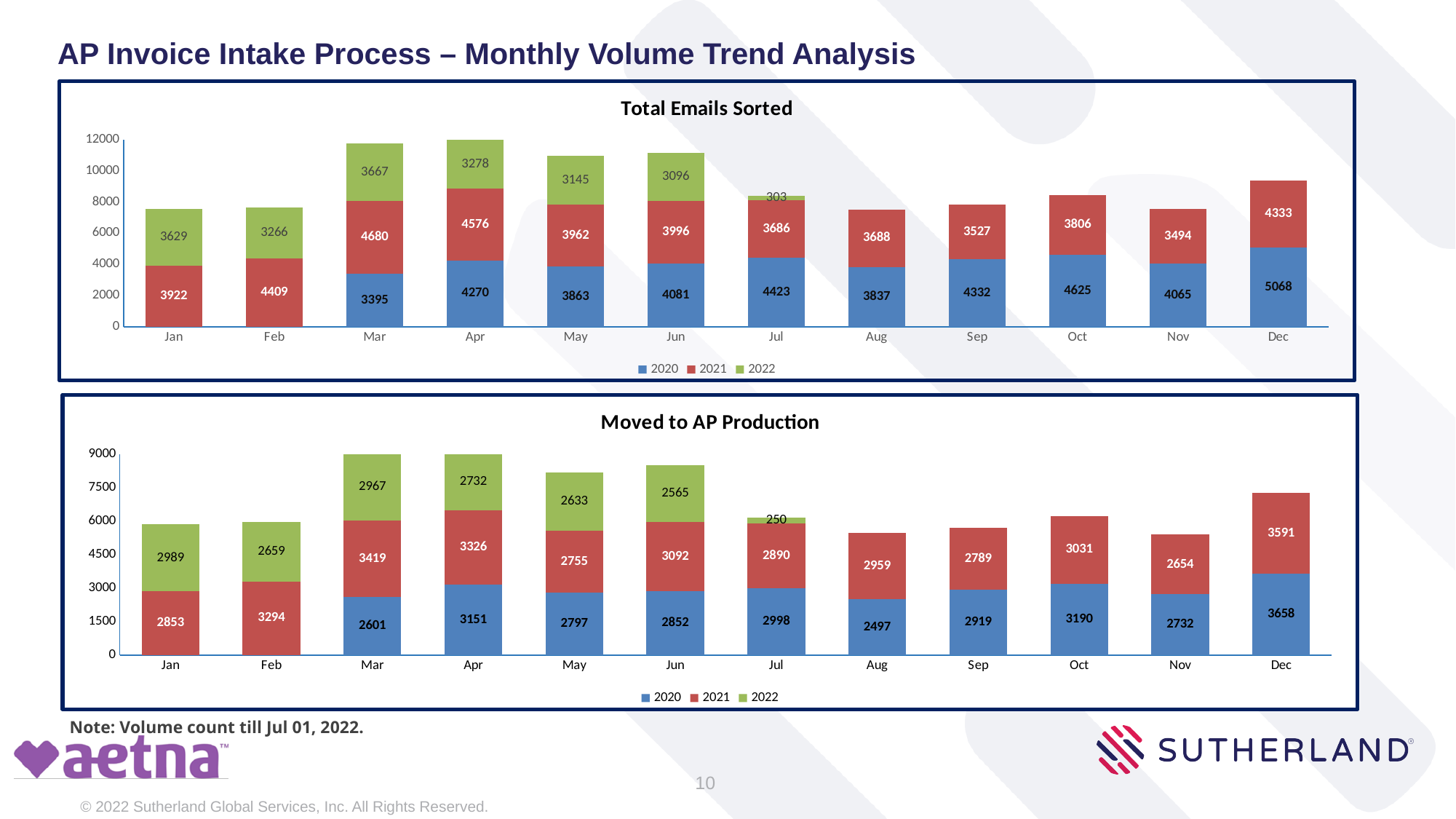
In the Moved to AP Production chart, what is the 2020 value for Dec? 3658 What kind of chart is the Moved to AP Production chart? Stacked bar chart In the Moved to AP Production chart, which is larger: the 2021 value for Jun or the 2021 value for May? Jun In the Total Emails Sorted chart, what is the total of the stacked bar for Mar? 11742 In the Total Emails Sorted chart, which month has the highest 2020 value? Dec In the Total Emails Sorted chart, what is the difference between the 2020 values for Dec and Nov? 1003 In the Total Emails Sorted chart, what is the 2022 value for Jul? 303 How many series does the legend of the Total Emails Sorted chart list? 3 In the Moved to AP Production chart, what is the total of the stacked bar for Dec? 7249 In the Moved to AP Production chart, what is the 2022 value for Mar? 2967 In the Moved to AP Production chart, which month has the lowest 2020 value? Aug In the Total Emails Sorted chart, what is the 2021 value for Mar? 4680